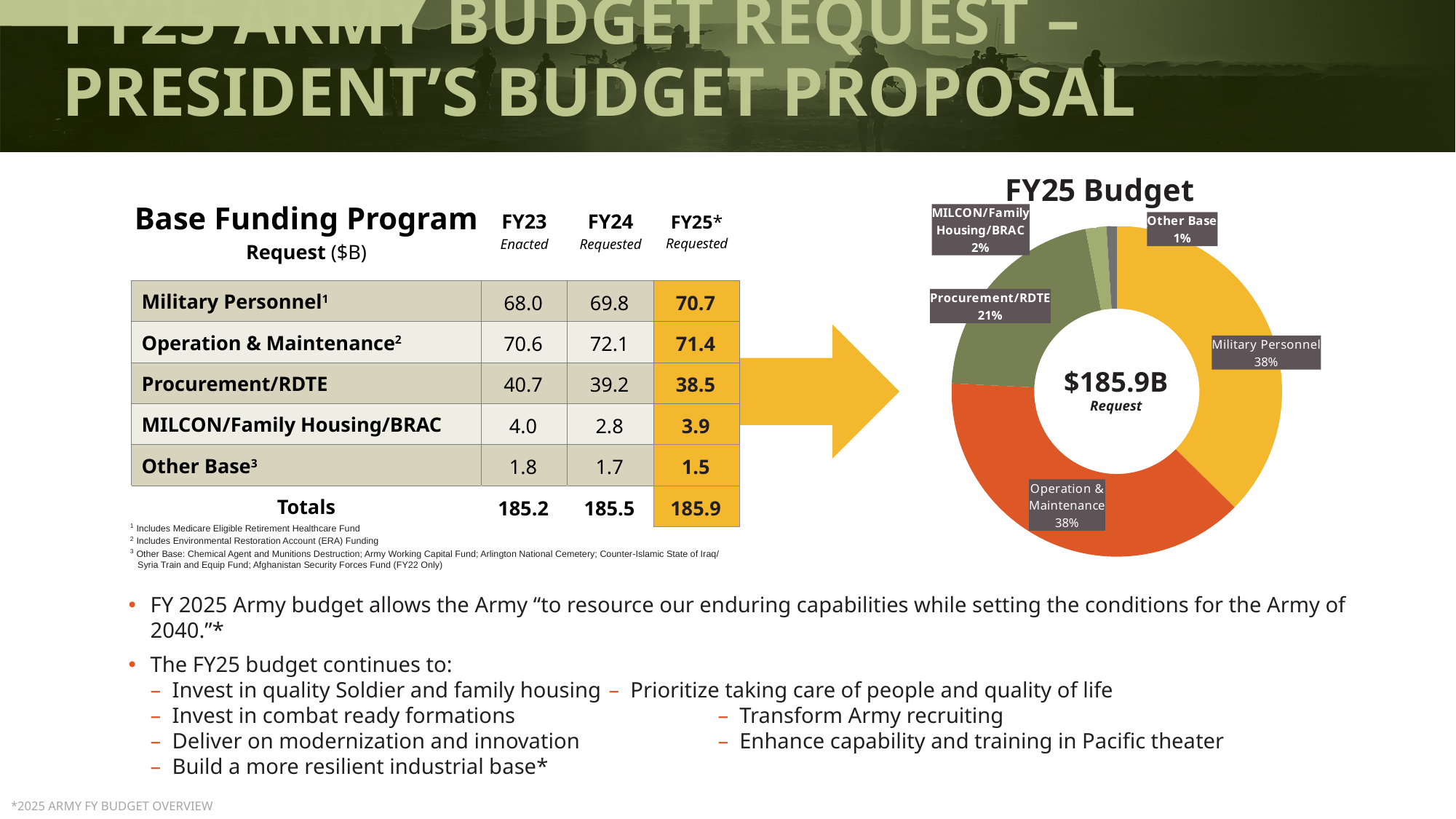
In the FY25 Budget chart, how many percentage points larger is Military Personnel's share than Procurement/RDTE's share? 17 What total request amount is shown in the center of the FY25 Budget chart? $185.9B In the FY25 Budget chart, which is larger: Procurement/RDTE or MILCON/Family Housing/BRAC? Procurement/RDTE In the FY25 Budget chart, what share does Military Personnel have? 38% In the FY25 Budget chart, what share does Procurement/RDTE have? 21% In the FY25 Budget chart, what share does MILCON/Family Housing/BRAC have? 2% How many slices does the FY25 Budget chart have? 5 In the FY25 Budget chart, which category has the smallest share? Other Base What is the title of the pie chart on the slide? FY25 Budget What kind of chart is the FY25 Budget chart? doughnut chart